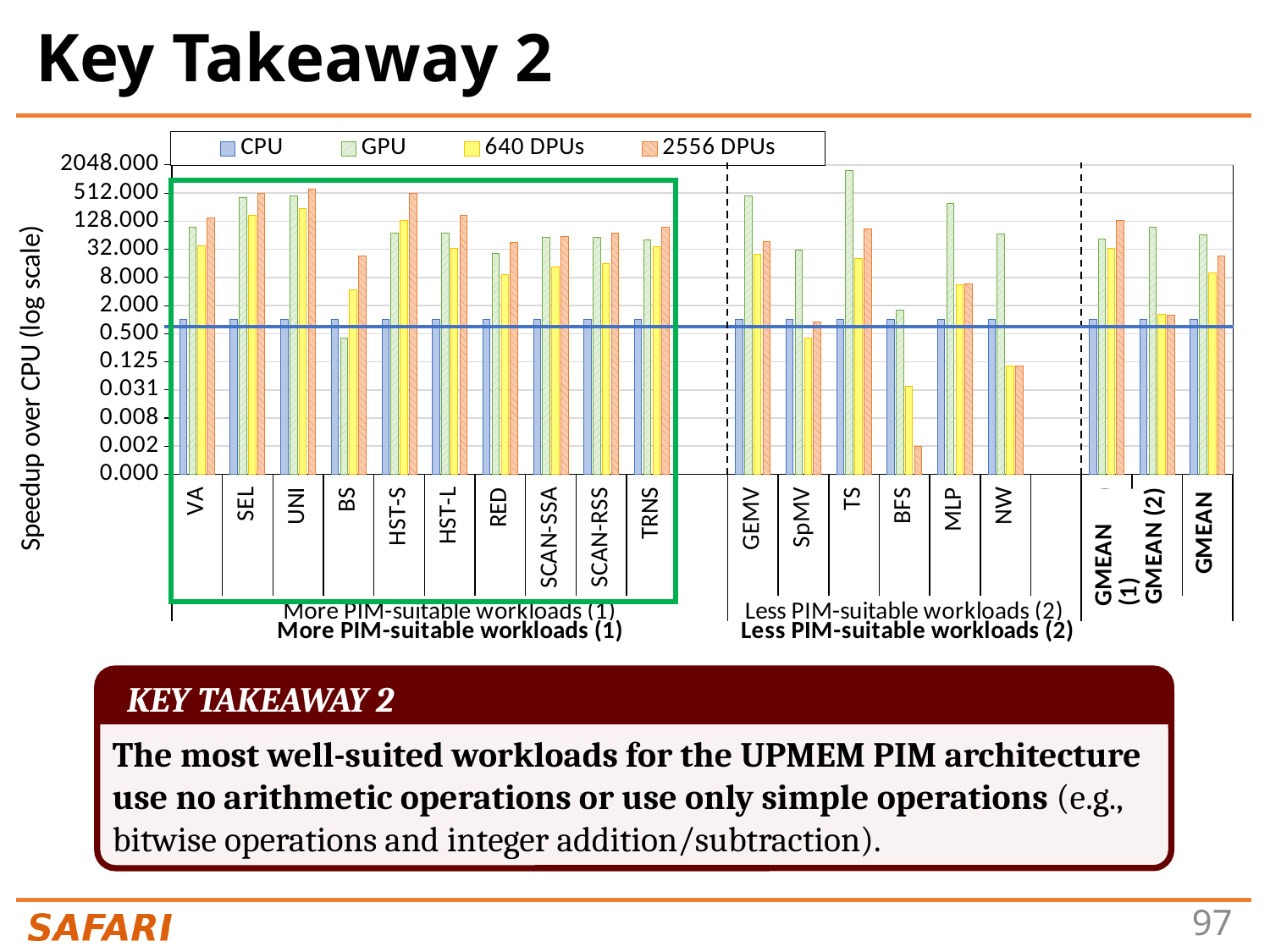
What is the label of the y axis? Speedup over CPU (log scale) Which workload has the highest GPU bar? TS Is the 2556 DPUs value for BFS greater or less than 0.031? less What kind of chart is shown on the slide? bar chart How many series does the legend list? 4 Is the GPU value for TS greater or less than 512.000? greater Is the 640 DPUs value for NW greater or less than 0.500? less How many workloads are grouped under "More PIM-suitable workloads (1)"? 10 Which workload has the lowest 2556 DPUs bar? BFS How many workloads are grouped under "Less PIM-suitable workloads (2)"? 6 For BS, which is larger: the GPU bar or the 2556 DPUs bar? 2556 DPUs